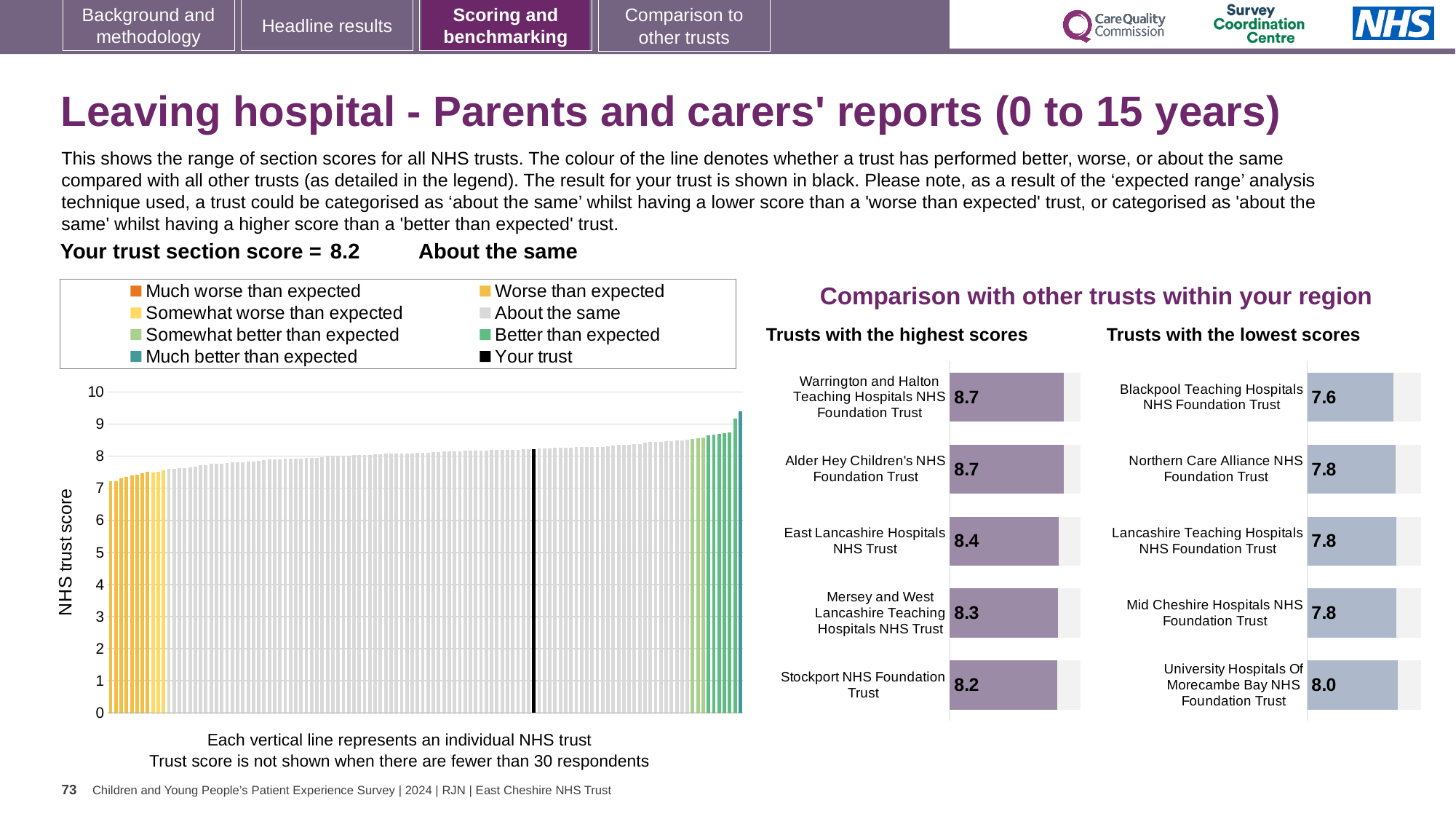
In the chart on the left, is the value of the tallest bar greater or less than 9? greater What kind of chart is the large chart on the left showing NHS trust scores? bar chart In the 'Trusts with the highest scores' chart, what is the difference between the scores of Warrington and Halton Teaching Hospitals NHS Foundation Trust and Stockport NHS Foundation Trust? 0.5 In the 'Trusts with the lowest scores' chart, what is the score for Blackpool Teaching Hospitals NHS Foundation Trust? 7.6 In the 'Trusts with the lowest scores' chart, what is the difference between the scores of University Hospitals Of Morecambe Bay NHS Foundation Trust and Blackpool Teaching Hospitals NHS Foundation Trust? 0.4 In the 'Trusts with the highest scores' chart, which trust has the lowest score? Stockport NHS Foundation Trust In the 'Trusts with the highest scores' chart, which has the higher score: East Lancashire Hospitals NHS Trust or Mersey and West Lancashire Teaching Hospitals NHS Trust? East Lancashire Hospitals NHS Trust In the 'Trusts with the lowest scores' chart, which trust has the highest score? University Hospitals Of Morecambe Bay NHS Foundation Trust In the 'Trusts with the highest scores' chart, what is the score for East Lancashire Hospitals NHS Trust? 8.4 In the chart on the left, what is the label on the vertical axis? NHS trust score In the 'Trusts with the highest scores' chart, how many trusts are shown? 5 How many entries does the legend above the chart on the left list? 8